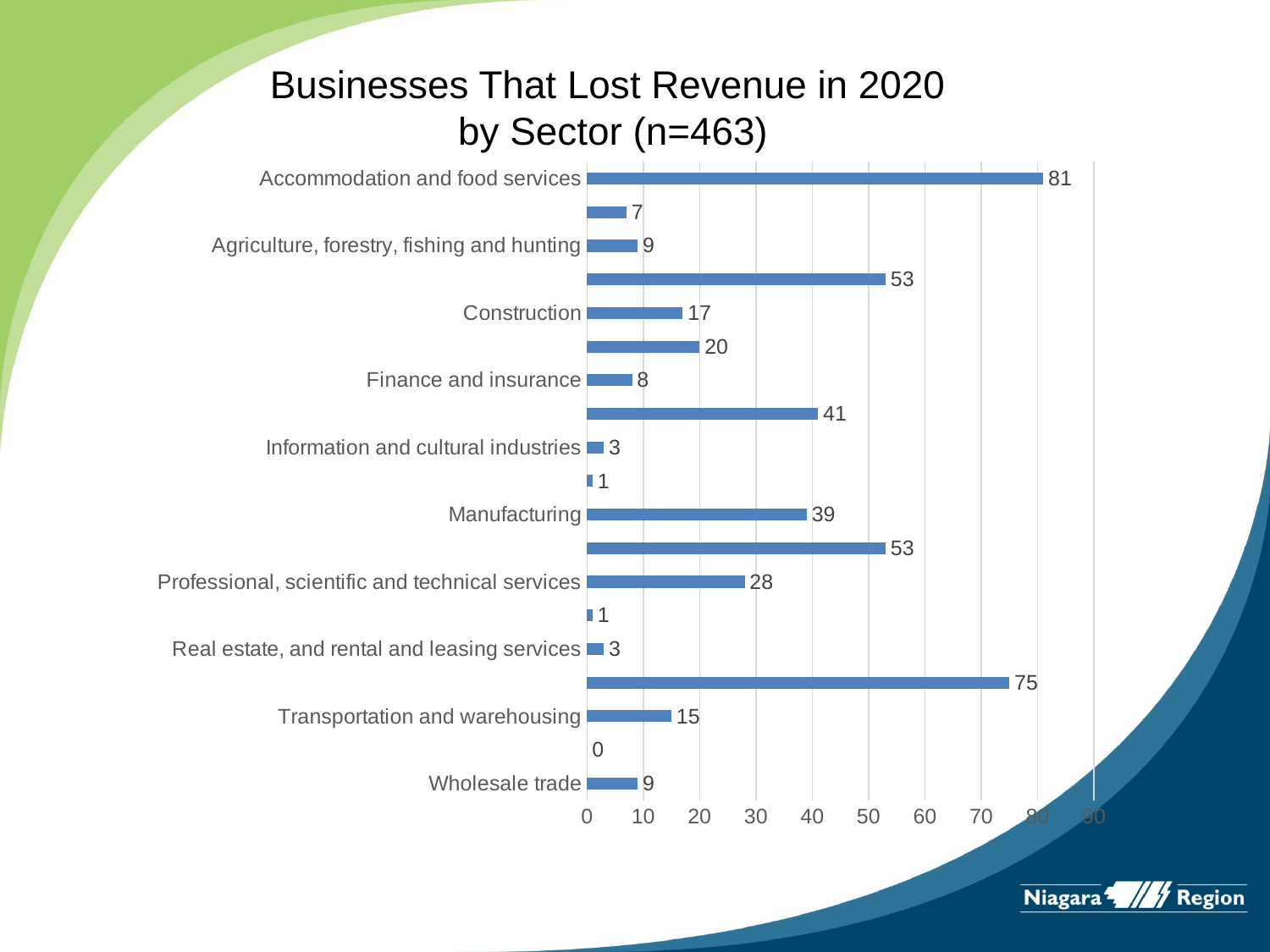
What is the value for Construction? 17 What is the value for Professional, scientific and technical services? 28 What is the title of the chart? Businesses That Lost Revenue in 2020 by Sector (n=463) What is the value for Finance and insurance? 8 What is the value for Manufacturing? 39 What is the difference between the values for Accommodation and food services and Manufacturing? 42 Which is larger, the value for Manufacturing or the value for Professional, scientific and technical services? Manufacturing How many bars are plotted in the chart? 19 What is the value for Accommodation and food services? 81 Is the value for Transportation and warehousing greater or less than 20? less What type of chart is shown on the slide? Bar chart Which labeled sector has the highest value? Accommodation and food services